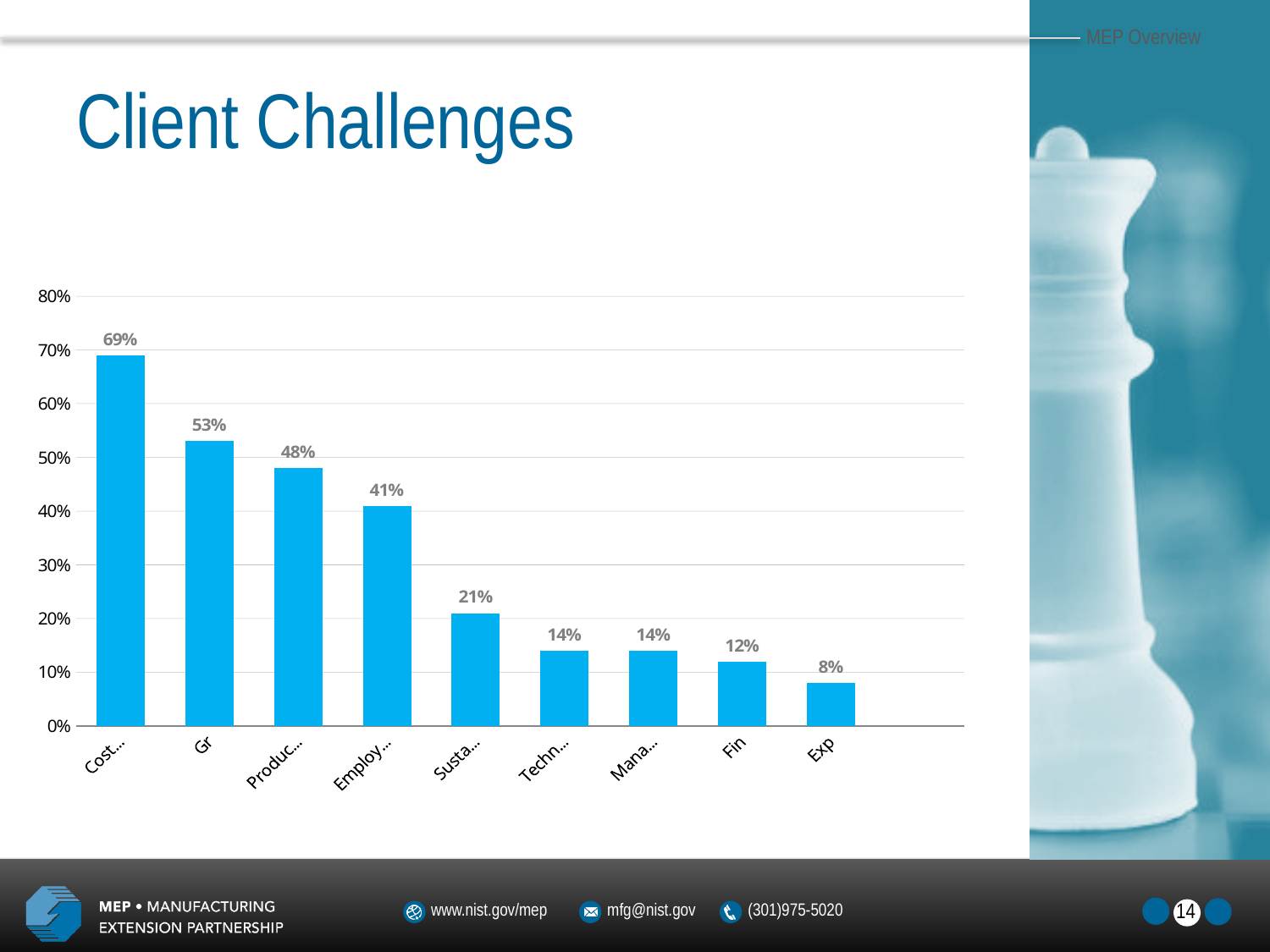
How many bars are plotted in the chart? 9 Do the values rise or fall from left to right along the x axis? fall What is the value of the last bar, labelled "Exp"? 8% Which is larger, the value for "Produc..." or the value for "Susta..."? Produc... Which category has the highest value? Cost... What is the value of the first bar, labelled "Cost..."? 69% What type of chart is shown on the slide? bar chart What is the value of the bar labelled "Gr"? 53% Which category has the lowest value? Exp What is the value of the bar labelled "Employ..."? 41% What is the difference between the values for "Cost..." and "Gr"? 16% What is the title of the slide containing the chart? Client Challenges